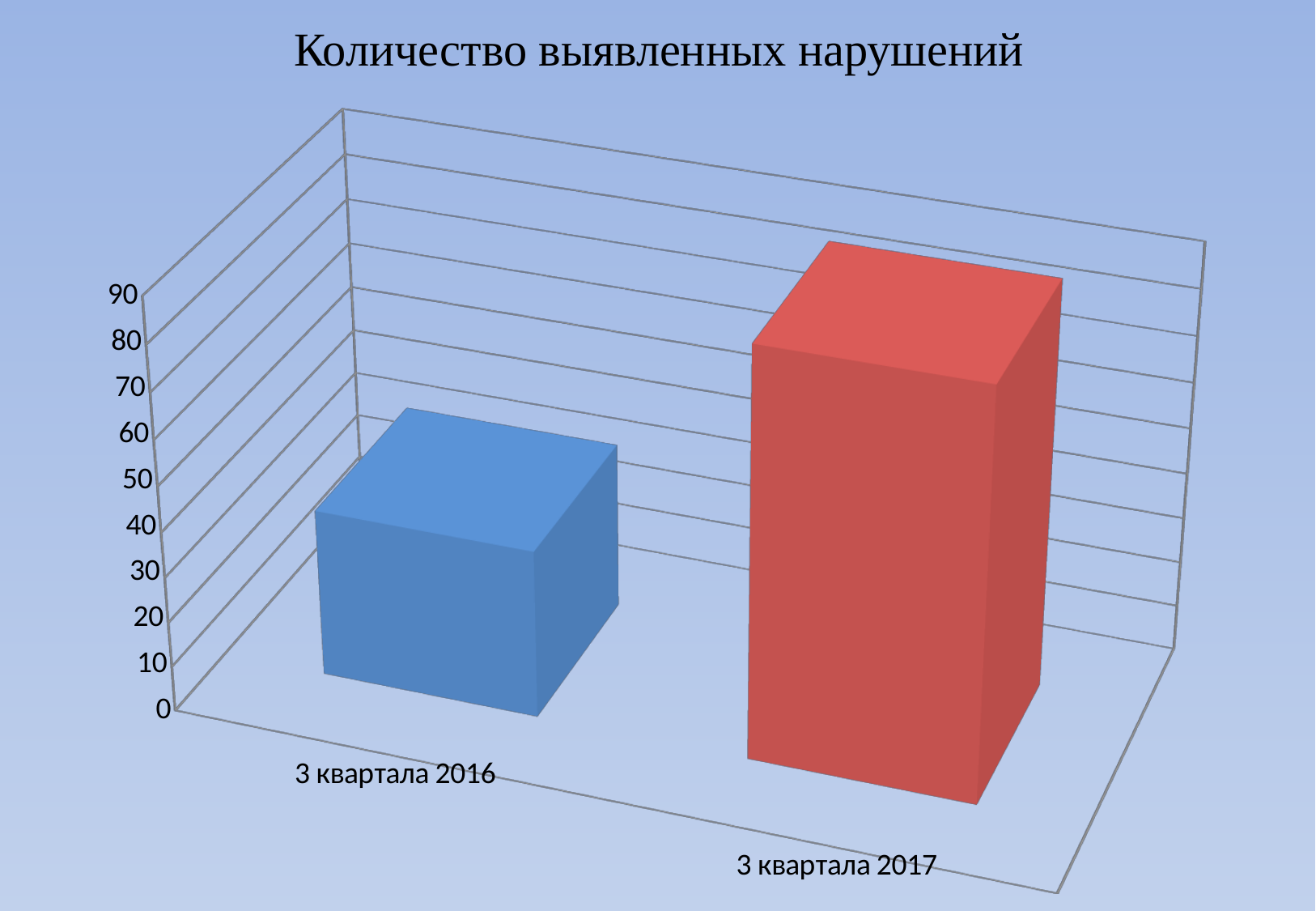
What colour is the bar for 3 квартала 2017? red Which is larger, the value for 3 квартала 2016 or the value for 3 квартала 2017? 3 квартала 2017 Which category has the highest value? 3 квартала 2017 Do the values rise or fall from 3 квартала 2016 to 3 квартала 2017? rise Is the value for 3 квартала 2016 greater or less than 50? less How many categories are shown on the x axis? 2 Is the value for 3 квартала 2017 greater or less than 60? greater What kind of chart is shown on the slide? bar chart Is the value for 3 квартала 2017 greater or less than 50? greater Which category has the lowest value? 3 квартала 2016 What is the title of the chart? Количество выявленных нарушений